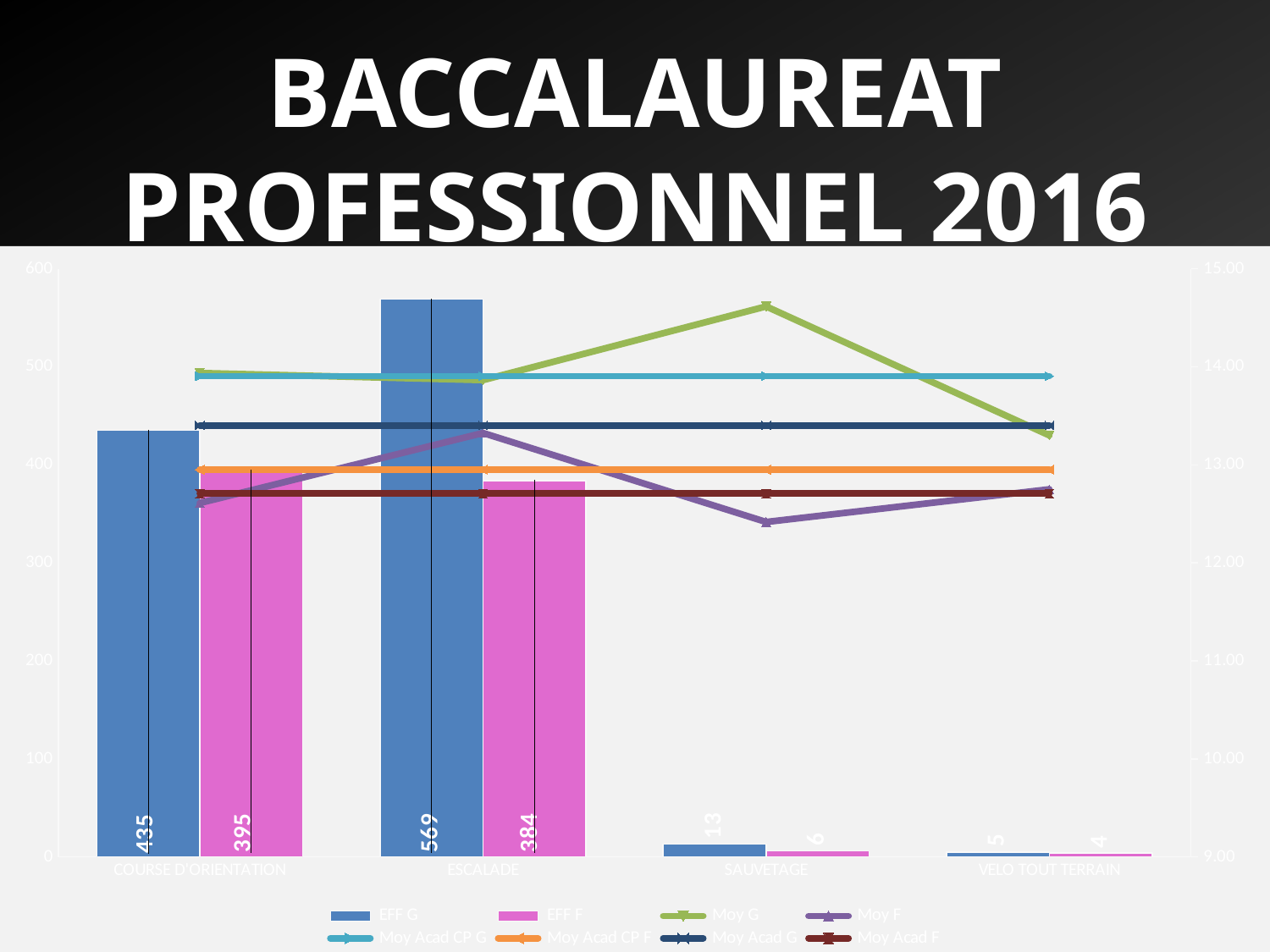
What is the EFF F value for COURSE D'ORIENTATION? 395 What is the EFF G value for SAUVETAGE? 13 Which category has the lowest EFF F value? VELO TOUT TERRAIN How many categories are shown on the x axis? 4 Is the Moy G value for SAUVETAGE greater or less than 14.00? greater What is the difference between the EFF G and EFF F values for ESCALADE? 185 Which category has the highest EFF G value? ESCALADE How many series does the legend list? 8 What is the difference between the EFF G and EFF F values for COURSE D'ORIENTATION? 40 Is the Moy F value for SAUVETAGE greater or less than 13.00? less For COURSE D'ORIENTATION, which is larger, EFF G or EFF F? EFF G What is the EFF G value for ESCALADE? 569